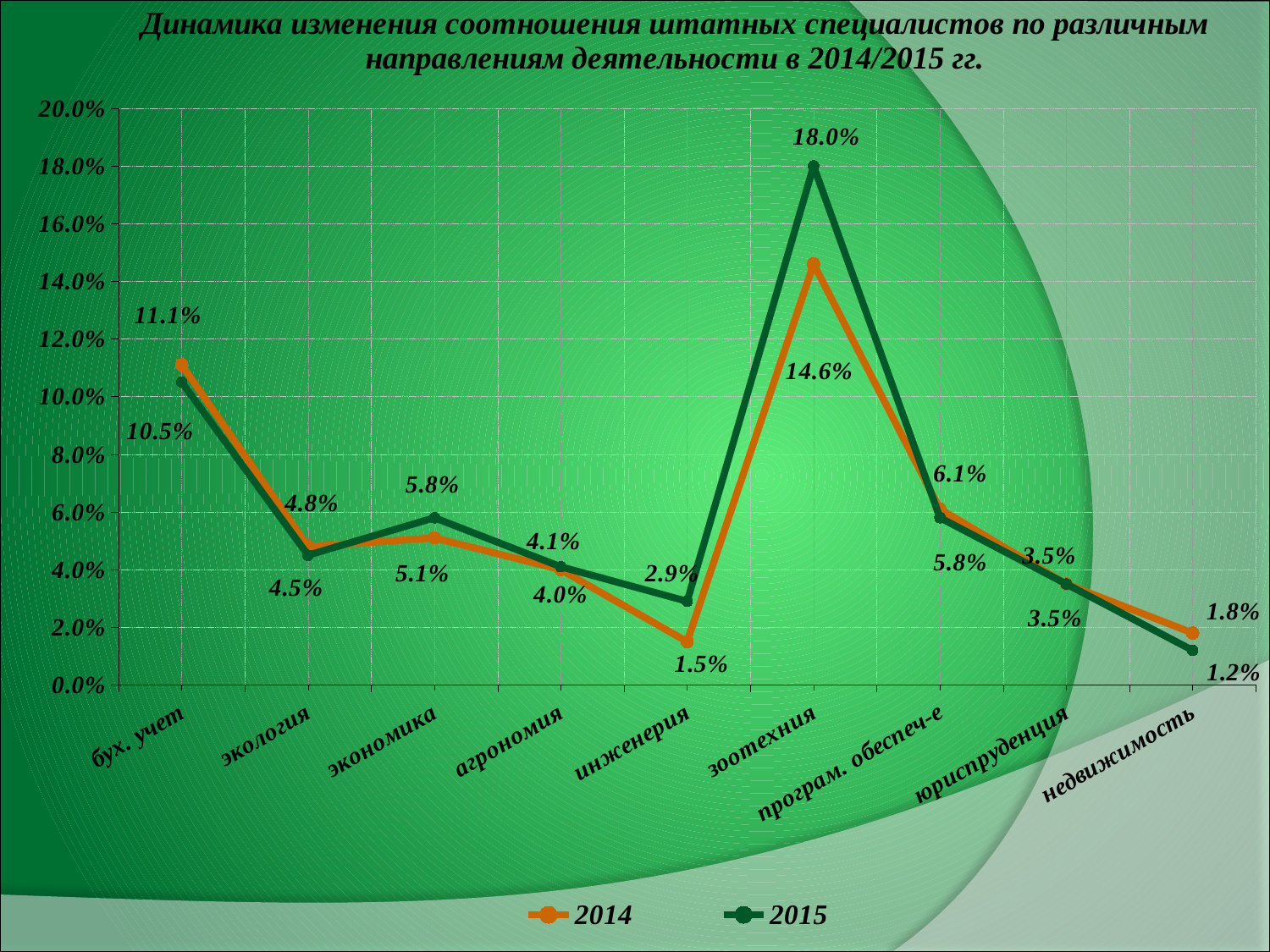
How many series does the legend list? 2 What is the difference between the 2015 and 2014 values for зоотехния? 3.4% What is the value for зоотехния in the 2015 series? 18.0% What kind of chart is shown on the slide? Line chart How many categories are shown along the x axis? 9 Which category has the lowest value in the 2014 series? инженерия For бух. учет, which series has the larger value, 2014 or 2015? 2014 Which category has the lowest value in the 2015 series? недвижимость Which category has the highest value in the 2015 series? зоотехния What is the value for недвижимость in the 2014 series? 1.8% What are the two entries listed in the legend? 2014 and 2015 What is the value for зоотехния in the 2014 series? 14.6%